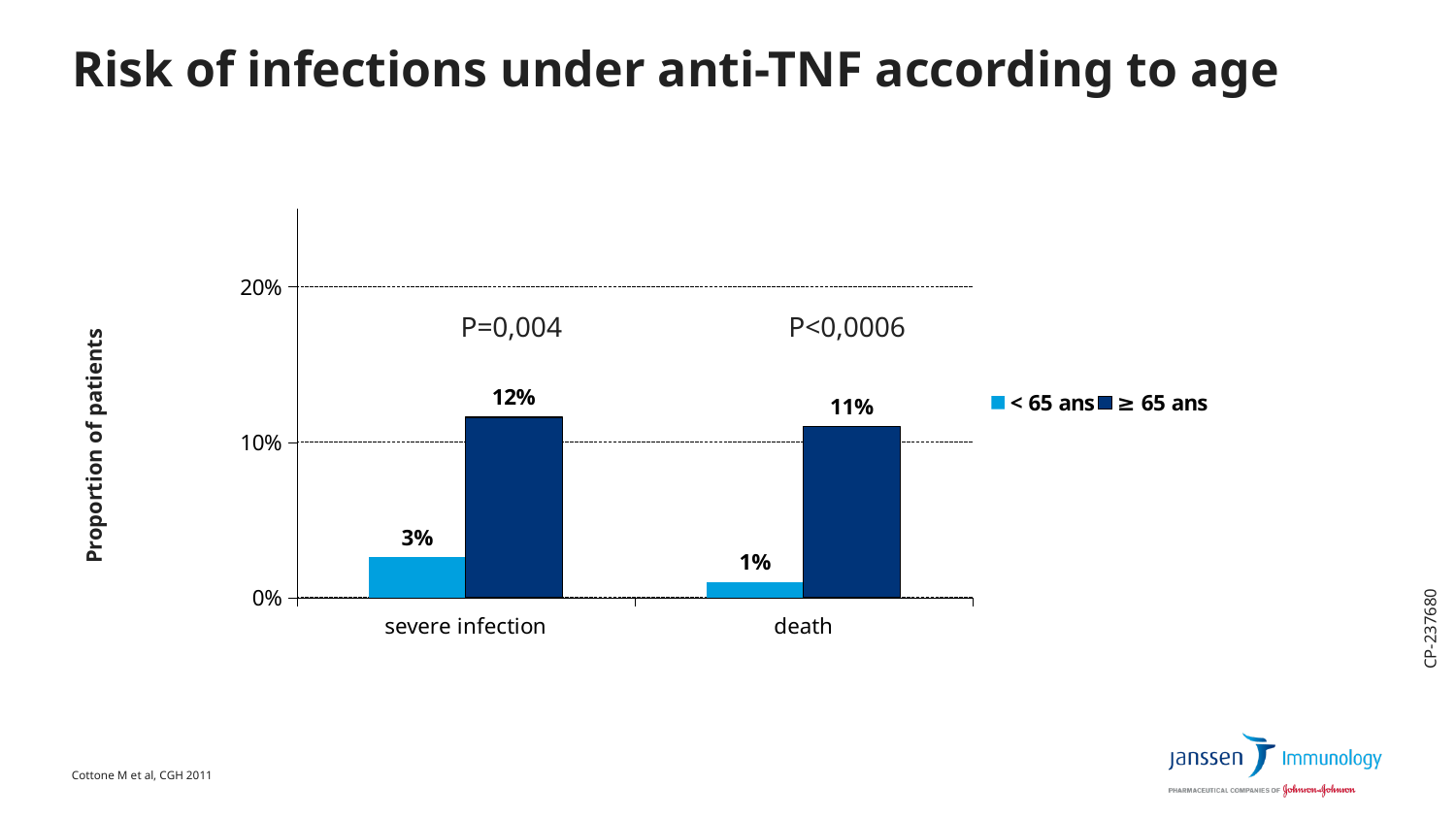
What is the proportion of patients aged 65 or over with severe infection? 12% How many series does the legend list? 2 What is the proportion of patients under 65 with severe infection? 3% What is the label of the y axis? Proportion of patients Which bar shows the highest proportion of patients? ≥ 65 ans, severe infection What is the difference between the ≥ 65 ans and < 65 ans values for severe infection? 9% What is the difference between the ≥ 65 ans and < 65 ans values for death? 10% What is the proportion of patients under 65 who died? 1% What kind of chart is shown? bar chart What is the proportion of patients aged 65 or over who died? 11% Which is larger: the < 65 ans value for severe infection or the < 65 ans value for death? severe infection Which bar shows the lowest proportion of patients? < 65 ans, death